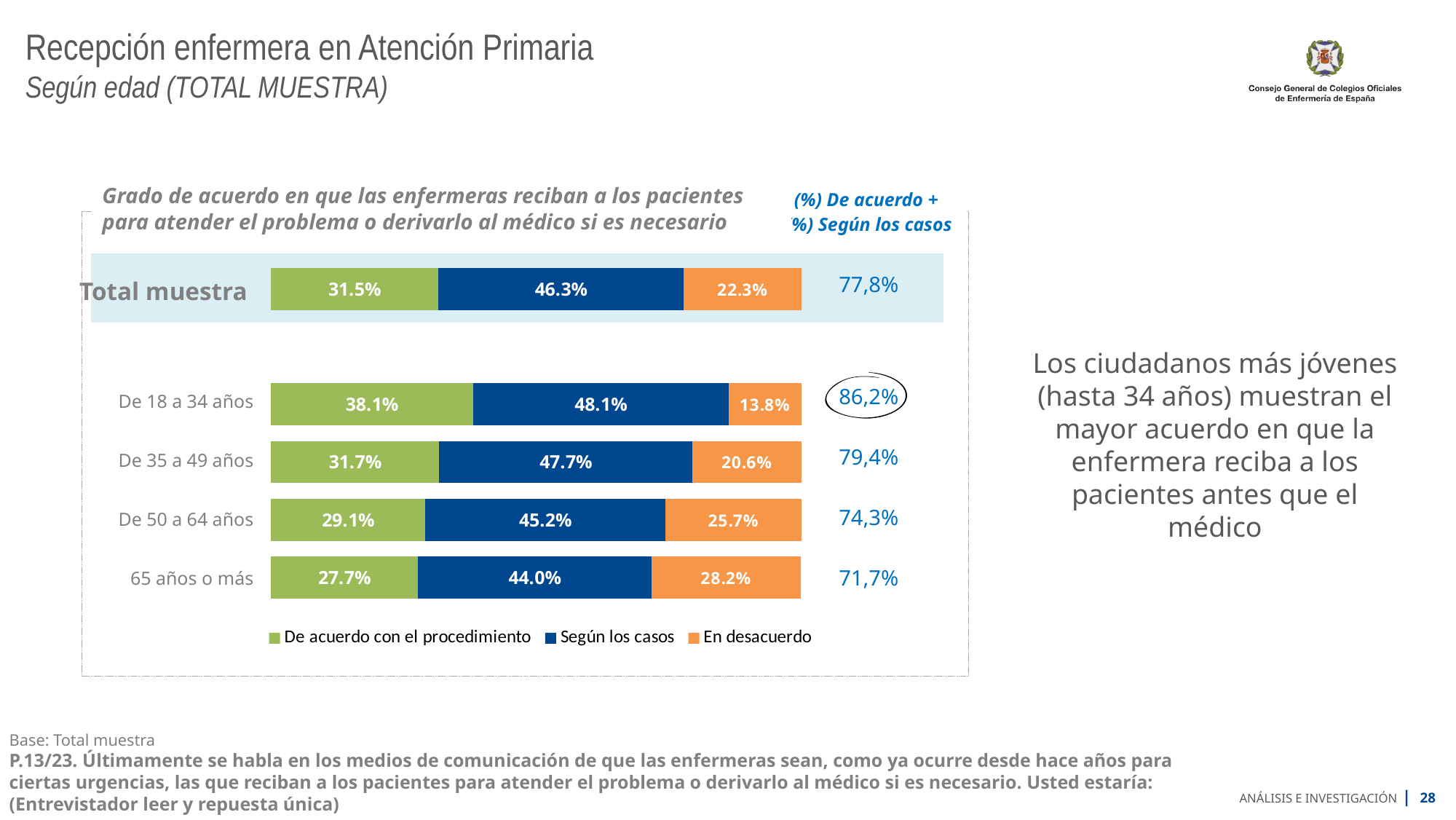
What is the combined '(%) De acuerdo + (%) Según los casos' value shown for 'De 50 a 64 años'? 74,3% What is the difference between the 'En desacuerdo' values for '65 años o más' and 'De 18 a 34 años'? 14.4% Which is larger: the 'Según los casos' value for 'De 35 a 49 años' or for 'De 50 a 64 años'? De 35 a 49 años What kind of chart is shown on the slide? Stacked bar chart How many series does the legend list? 3 Which age group has the highest 'De acuerdo con el procedimiento' percentage? De 18 a 34 años What percentage of the 'De 18 a 34 años' group answered 'De acuerdo con el procedimiento'? 38.1% Which colour represents 'En desacuerdo' in the legend? Orange How many bars are shown in the chart, including 'Total muestra'? 5 What is the 'Según los casos' value for 'Total muestra'? 46.3% What is the 'En desacuerdo' value for '65 años o más'? 28.2% Which age group has the lowest 'En desacuerdo' percentage? De 18 a 34 años